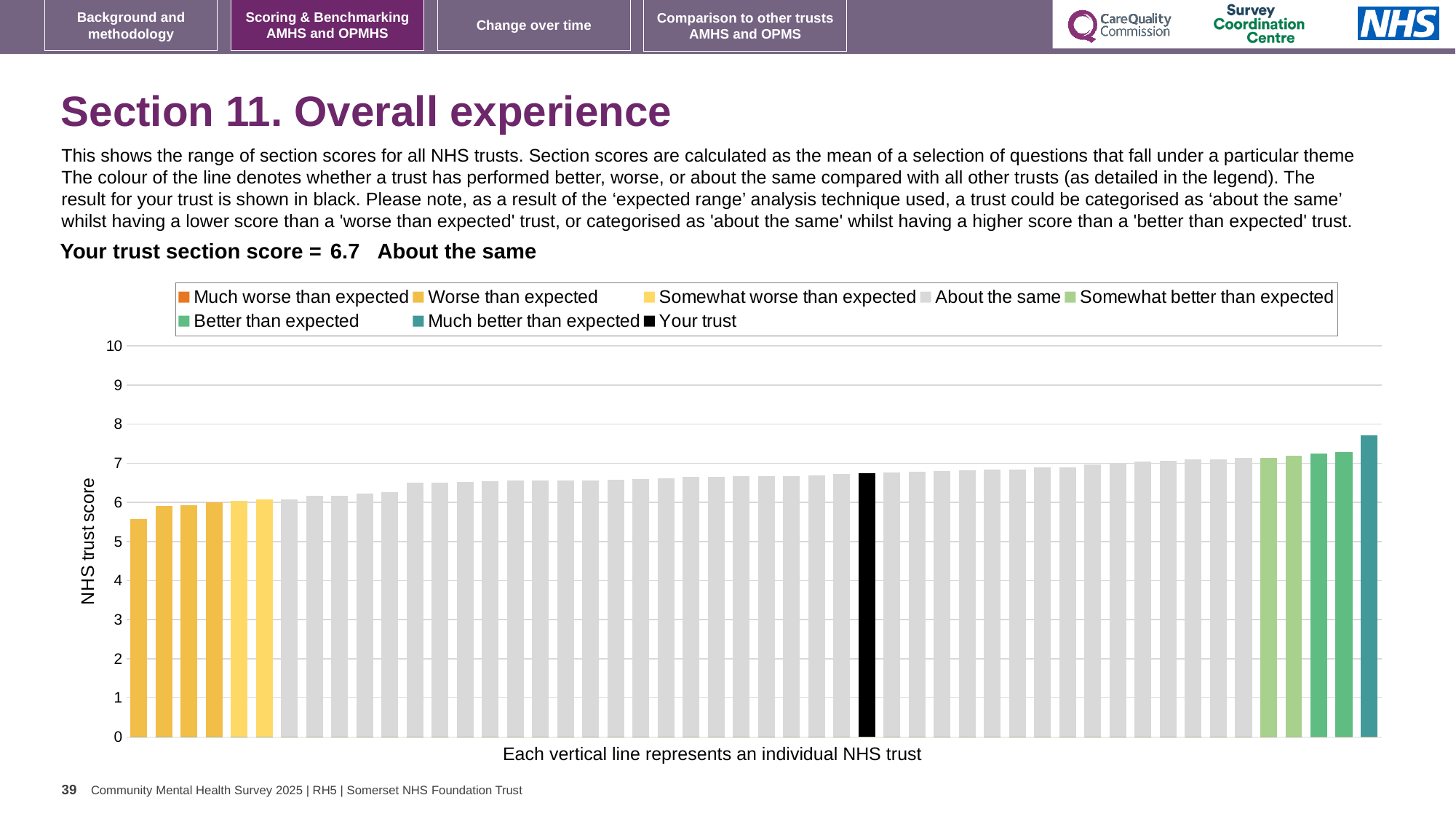
Is the value of the lowest bar greater or less than 6? less Is the value of the highest bar greater or less than 8? less Is the value of the highest bar greater or less than 7? greater Which legend category does the highest bar belong to? Much better than expected Which category is your trust placed in for this section? About the same What colour is the bar representing your trust? black What kind of chart is shown on the slide? bar chart How many entries does the chart legend list? 8 How many bars are coloured as 'Much worse than expected'? 0 Do the bar values rise or fall from left to right along the x axis? rise What is the section score for your trust shown on the slide? 6.7